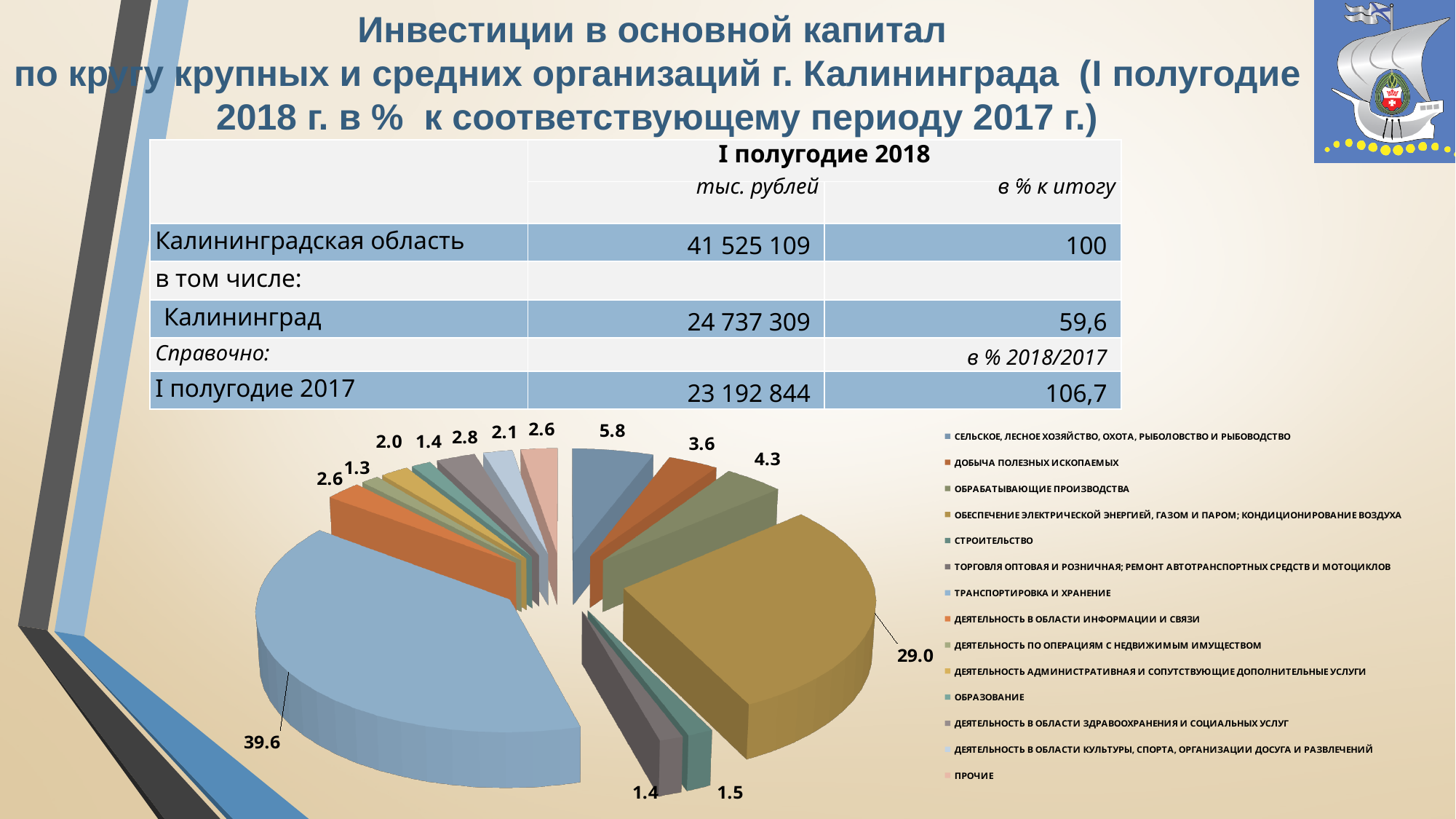
Which category has the largest share in the pie chart? Транспортировка и хранение What is the smallest value labelled on the pie chart? 1.3 What is the difference between the values for Транспортировка и хранение and Обеспечение электрической энергией, газом и паром; кондиционирование воздуха? 10.6 How many categories does the legend of the pie chart list? 14 What is the value shown for Транспортировка и хранение in the pie chart? 39.6 Which is larger in the pie chart: Транспортировка и хранение or Обеспечение электрической энергией, газом и паром; кондиционирование воздуха? Транспортировка и хранение What is the last entry listed in the pie chart's legend? Прочие What is the value shown for Обрабатывающие производства in the pie chart? 4.3 What is the value shown for Сельское, лесное хозяйство, охота, рыболовство и рыбоводство in the pie chart? 5.8 What kind of chart is shown on the slide? pie chart What is the value shown for Добыча полезных ископаемых in the pie chart? 3.6 What is the value shown for Обеспечение электрической энергией, газом и паром; кондиционирование воздуха in the pie chart? 29.0